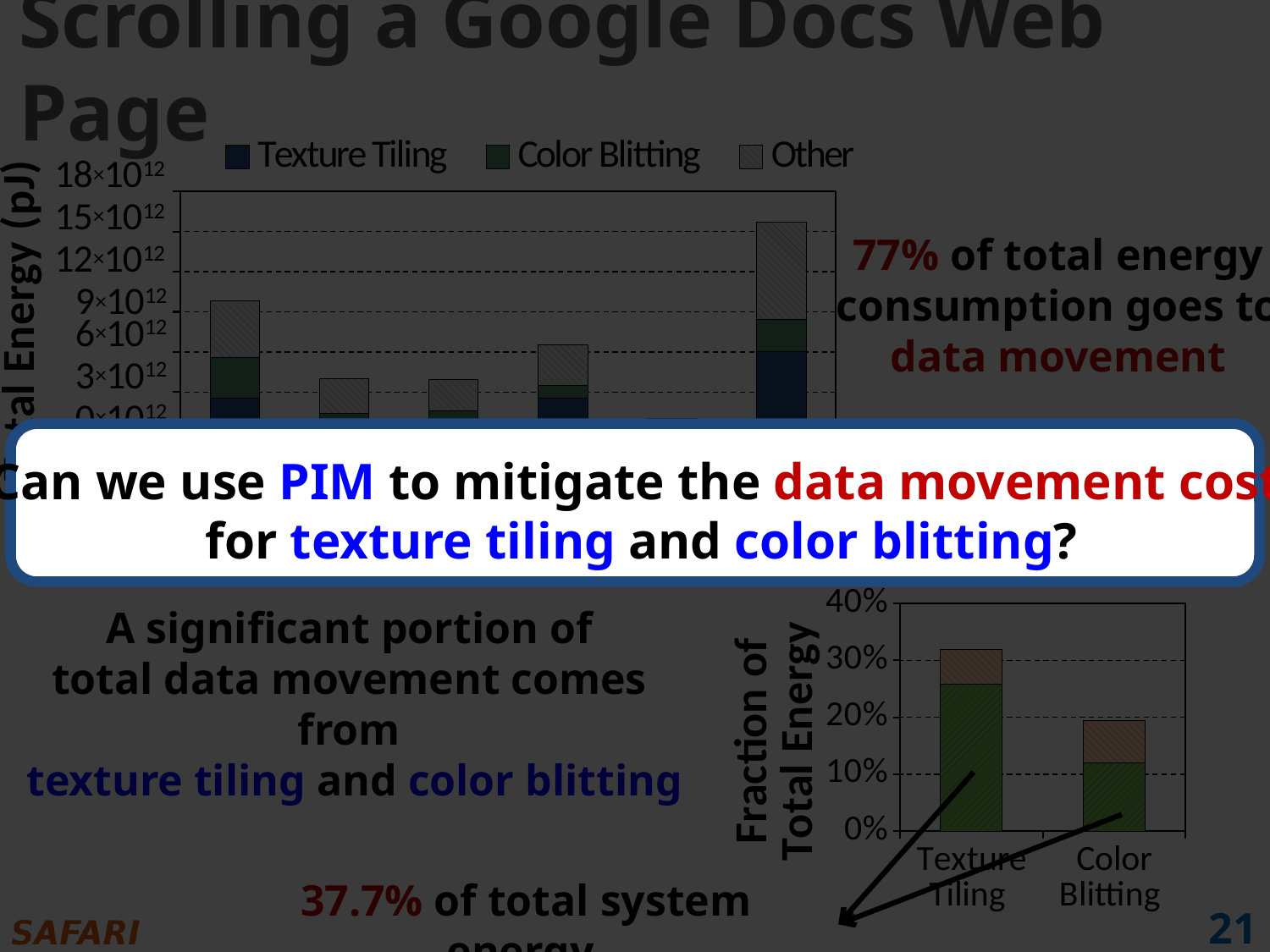
In the bottom-right chart (Fraction of Total Energy), which category has the higher bar? Texture Tiling What kind of chart is the bottom-right chart (Fraction of Total Energy)? bar chart How many series does the legend of the top chart (Total Energy) list? 3 What is the highest tick label on the y axis of the top chart (Total Energy)? 18×10^12 In the bottom-right chart (Fraction of Total Energy), is the bar for Texture Tiling larger or smaller than the bar for Color Blitting? larger In the bottom-right chart (Fraction of Total Energy), which category has the lower bar? Color Blitting In the bottom-right chart (Fraction of Total Energy), is the value for Texture Tiling greater or less than 20%? greater In the bottom-right chart (Fraction of Total Energy), is the value for Color Blitting greater or less than 30%? less In the bottom-right chart (Fraction of Total Energy), is the value for Color Blitting greater or less than 10%? greater How many categories are shown on the x axis of the bottom-right chart (Fraction of Total Energy)? 2 What are the three legend entries of the top chart (Total Energy)? Texture Tiling, Color Blitting, Other What kind of chart is the top chart (Total Energy)? stacked bar chart